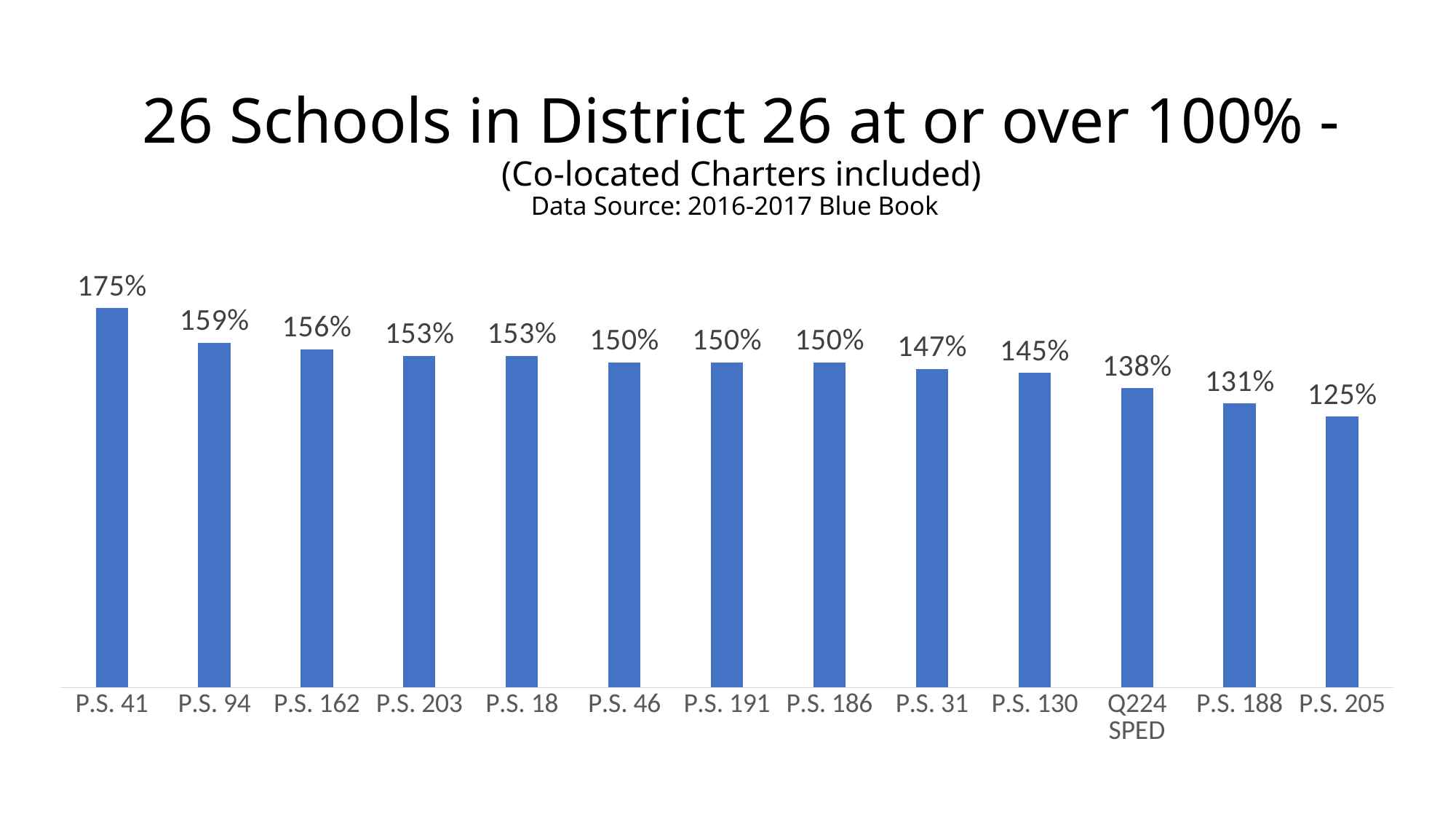
What is the value for P.S. 31? 147% What is the difference between the values for P.S. 94 and P.S. 130? 14% What kind of chart is this? Bar chart How many schools are shown on the chart? 13 Which school has the lowest value? P.S. 205 Which school has the highest value? P.S. 41 What data source is cited in the chart title? 2016-2017 Blue Book Do the values rise or fall from left to right along the x axis? Fall What is the value for P.S. 41? 175% Which is larger, the value for P.S. 162 or the value for P.S. 188? P.S. 162 What is the value for Q224 SPED? 138% What is the difference between the values for P.S. 41 and P.S. 205? 50%